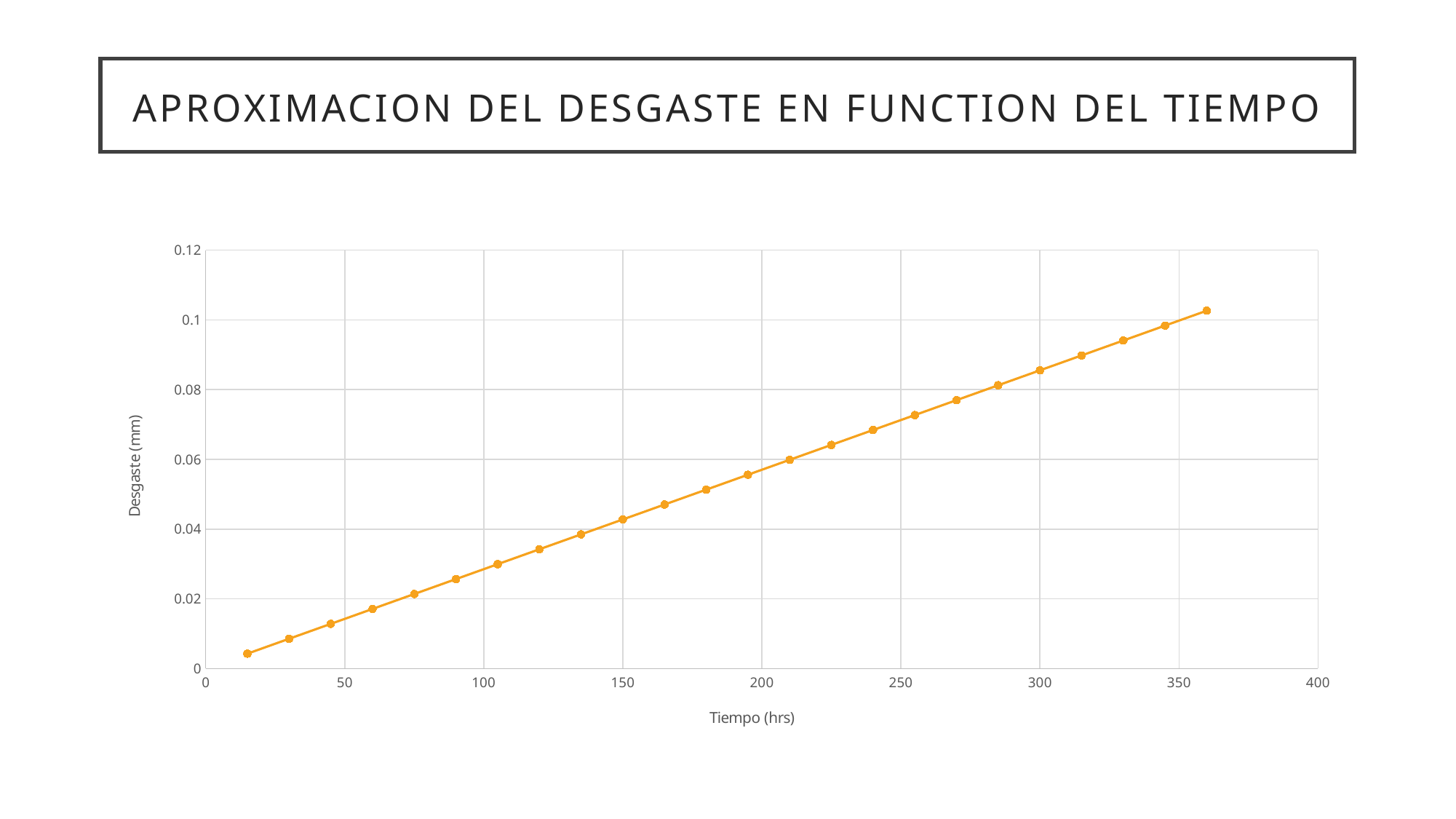
At which time (hrs) is the wear (Desgaste) lowest? 15 Is the value for 240 hrs greater or less than 0.08? less What is the label of the y axis? Desgaste (mm) What is the label of the x axis? Tiempo (hrs) Which has the larger wear value, 300 hrs or 150 hrs? 300 hrs Is the value for 60 hrs greater or less than 0.02? less Is the value for 360 hrs greater or less than 0.1? greater How many data points are plotted on the chart? 24 What kind of chart is shown on the slide? line chart At which time (hrs) is the wear (Desgaste) highest? 360 Do the values rise or fall as time increases along the x axis? rise